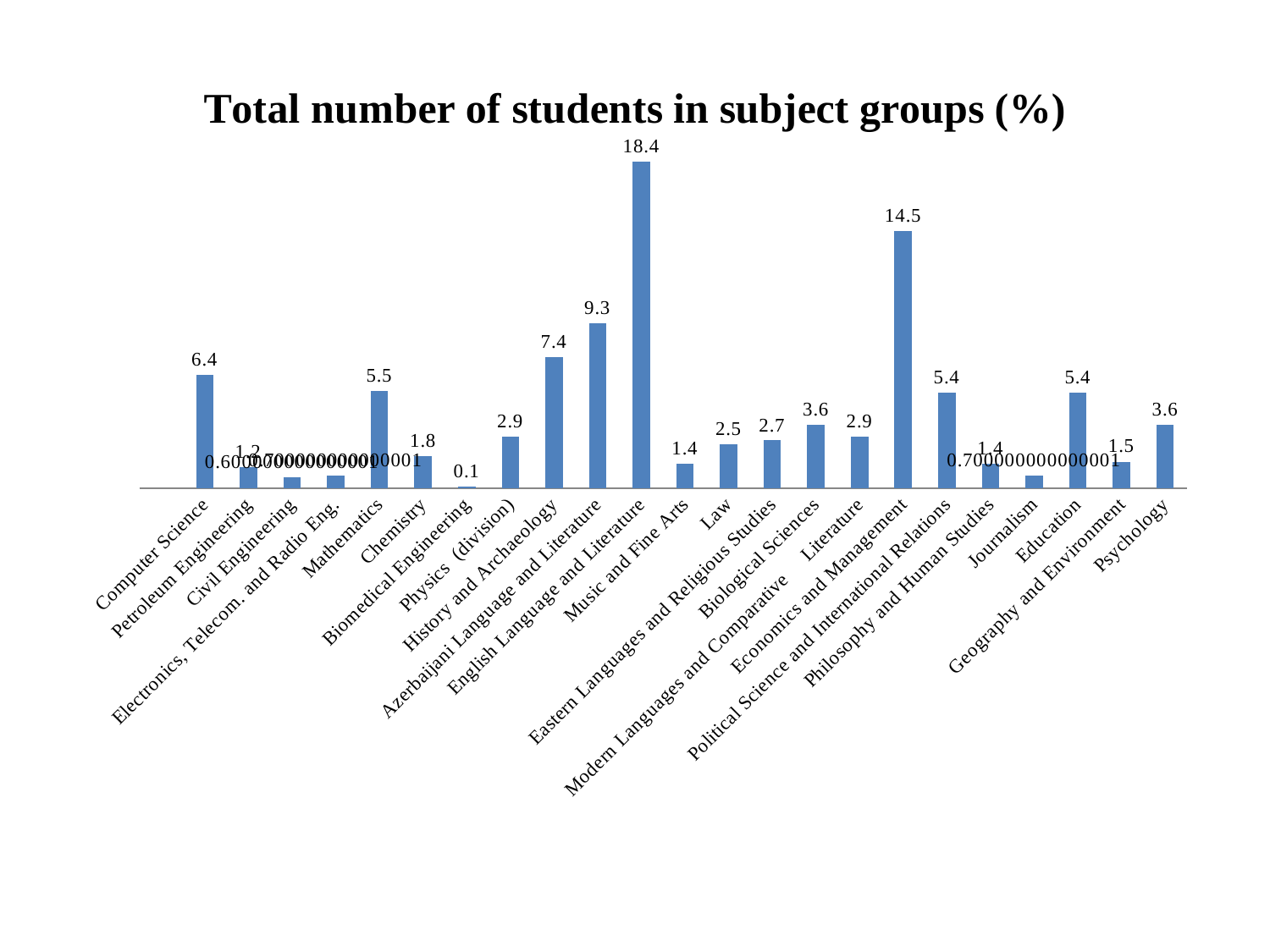
What is the difference between the values for English Language and Literature and Economics and Management? 3.9 What is the difference between the values for Computer Science and Mathematics? 0.9 What kind of chart is shown on the slide? Bar chart What is the value for Economics and Management? 14.5 Which is larger, the value for History and Archaeology or the value for Azerbaijani Language and Literature? Azerbaijani Language and Literature Which subject group has the lowest value? Biomedical Engineering What is the value for Mathematics? 5.5 How many subject groups are shown in the chart? 23 What is the title of the chart? Total number of students in subject groups (%) What is the value for Psychology? 3.6 Which subject group has the highest value? English Language and Literature What is the value for English Language and Literature? 18.4